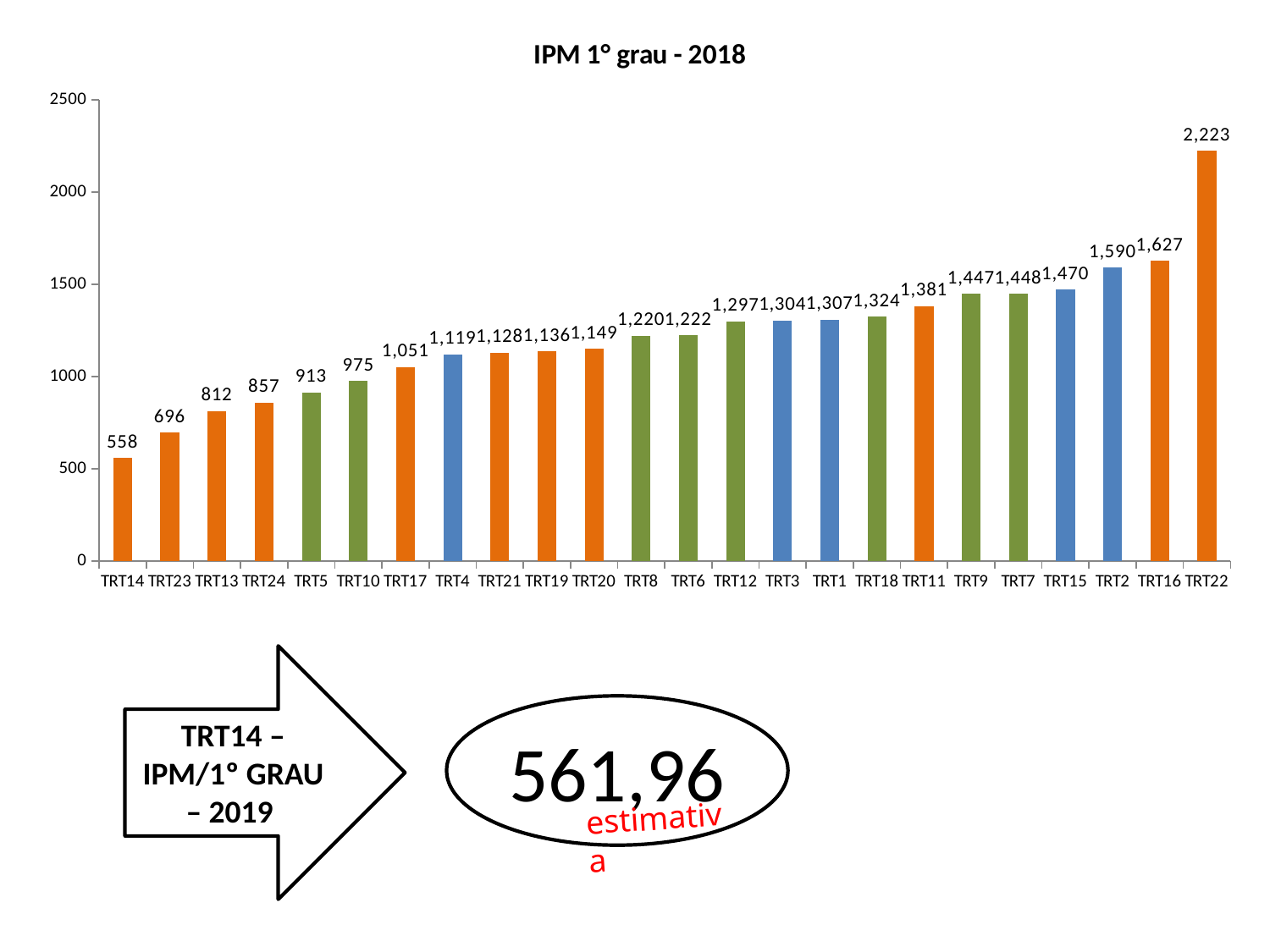
Which has a larger value, TRT5 or TRT2? TRT2 What kind of chart is shown on the slide? Bar chart What is the value for TRT10 in the chart? 975 What is the value for TRT14 in the chart? 558 Which category has the lowest value in the chart? TRT14 How many categories are shown in the chart? 24 What is the title of the chart? IPM 1° grau - 2018 What is the difference between the values for TRT22 and TRT14? 1,665 What is the value for TRT11 in the chart? 1,381 Which category has the highest value in the chart? TRT22 What is the difference between the values for TRT23 and TRT14? 138 What is the value for TRT22 in the chart? 2,223